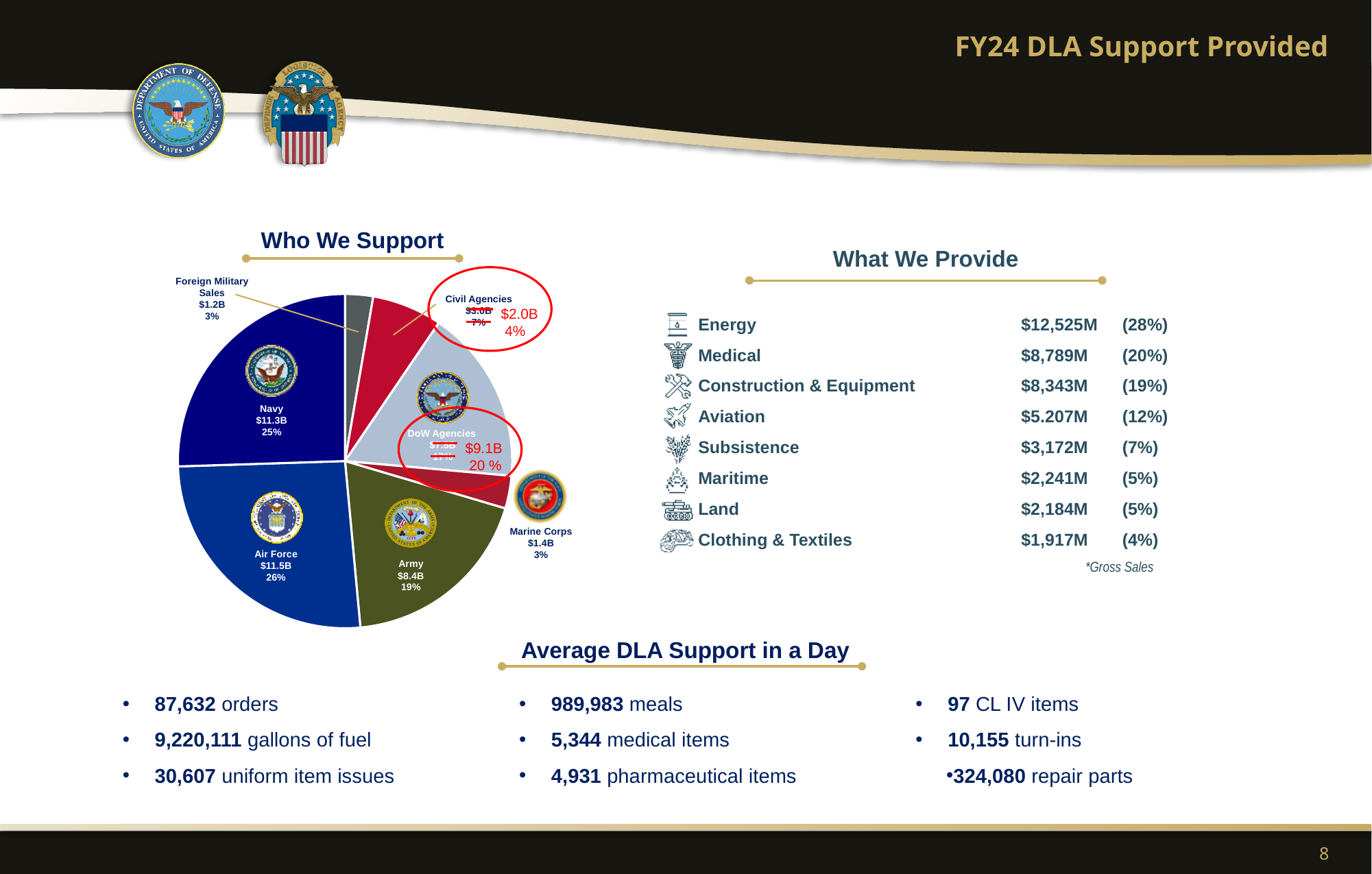
What is the title of the pie chart on the slide? Who We Support In the "Who We Support" pie chart, which category has the largest share? Air Force In the "Who We Support" pie chart, what is the difference in value between the Air Force and the Army? $3.1B How many slices does the "Who We Support" pie chart have? 7 What kind of chart is the "Who We Support" chart? Pie chart In the "Who We Support" pie chart, what is the value shown for Foreign Military Sales? $1.2B In the "Who We Support" pie chart, what is the difference in percentage share between the Navy and the Marine Corps? 22% In the "Who We Support" pie chart, what percentage share is shown for the Air Force? 26% In the "Who We Support" pie chart, what is the value shown for the Army? $8.4B In the "Who We Support" pie chart, what is the value shown for the Navy? $11.3B In the "Who We Support" pie chart, which is larger, the Navy or the Army? Navy In the "Who We Support" pie chart, what percentage share is shown for the Marine Corps? 3%